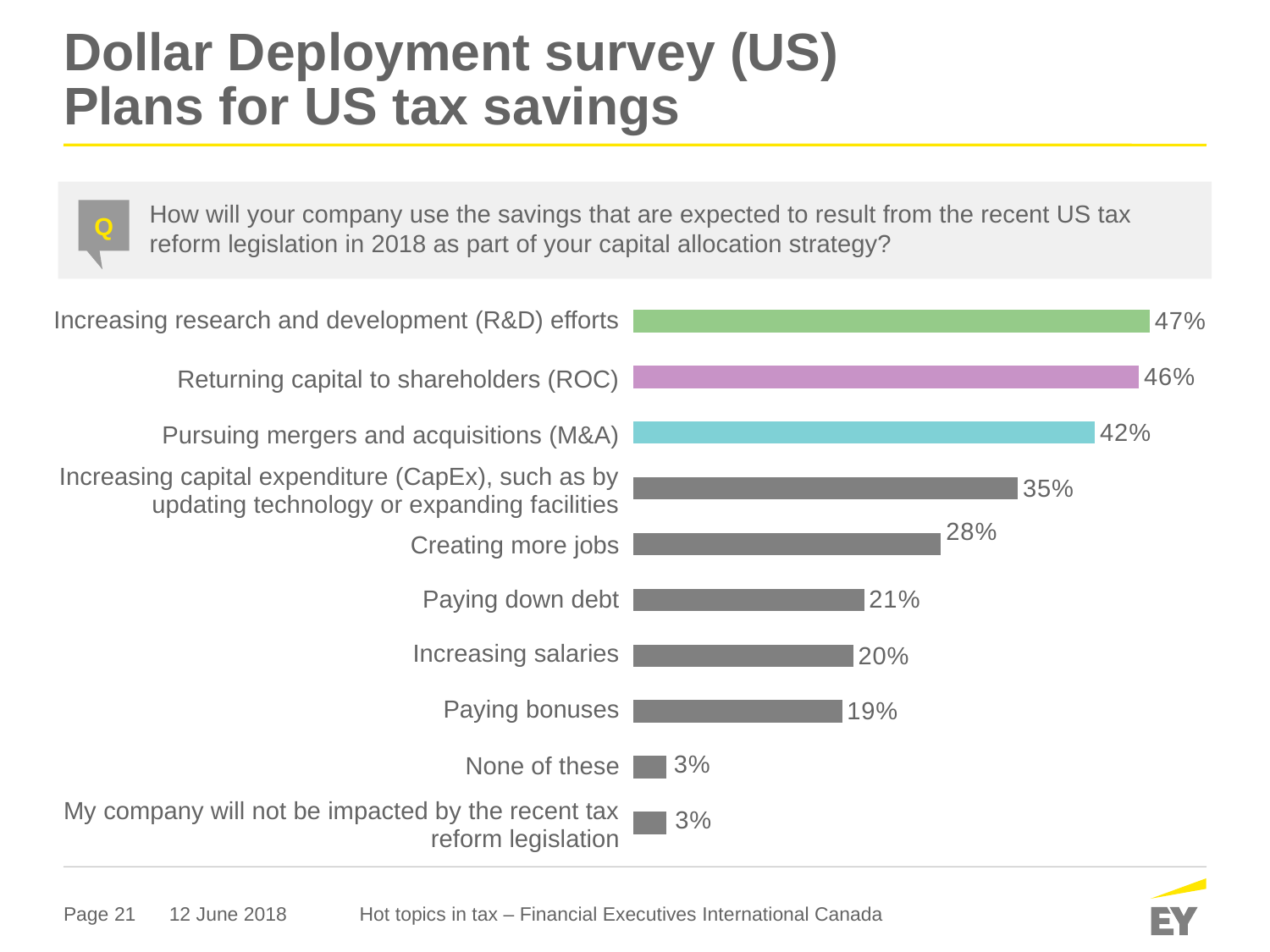
What value is shown for None of these? 3% What is the difference between the values for Paying down debt and Increasing salaries? 1% What is the value for Paying bonuses? 19% What is the value for Creating more jobs? 28% What is the difference between the values for Pursuing mergers and acquisitions (M&A) and Increasing capital expenditure (CapEx)? 7% What colour is the bar for Pursuing mergers and acquisitions (M&A)? Teal What is the value for Returning capital to shareholders (ROC)? 46% What kind of chart is shown on the slide? Bar chart Which is larger, the value for Creating more jobs or the value for Paying down debt? Creating more jobs How many categories are shown in the chart? 10 Which category has the highest value? Increasing research and development (R&D) efforts What percentage of respondents plan to use tax savings for increasing research and development (R&D) efforts? 47%